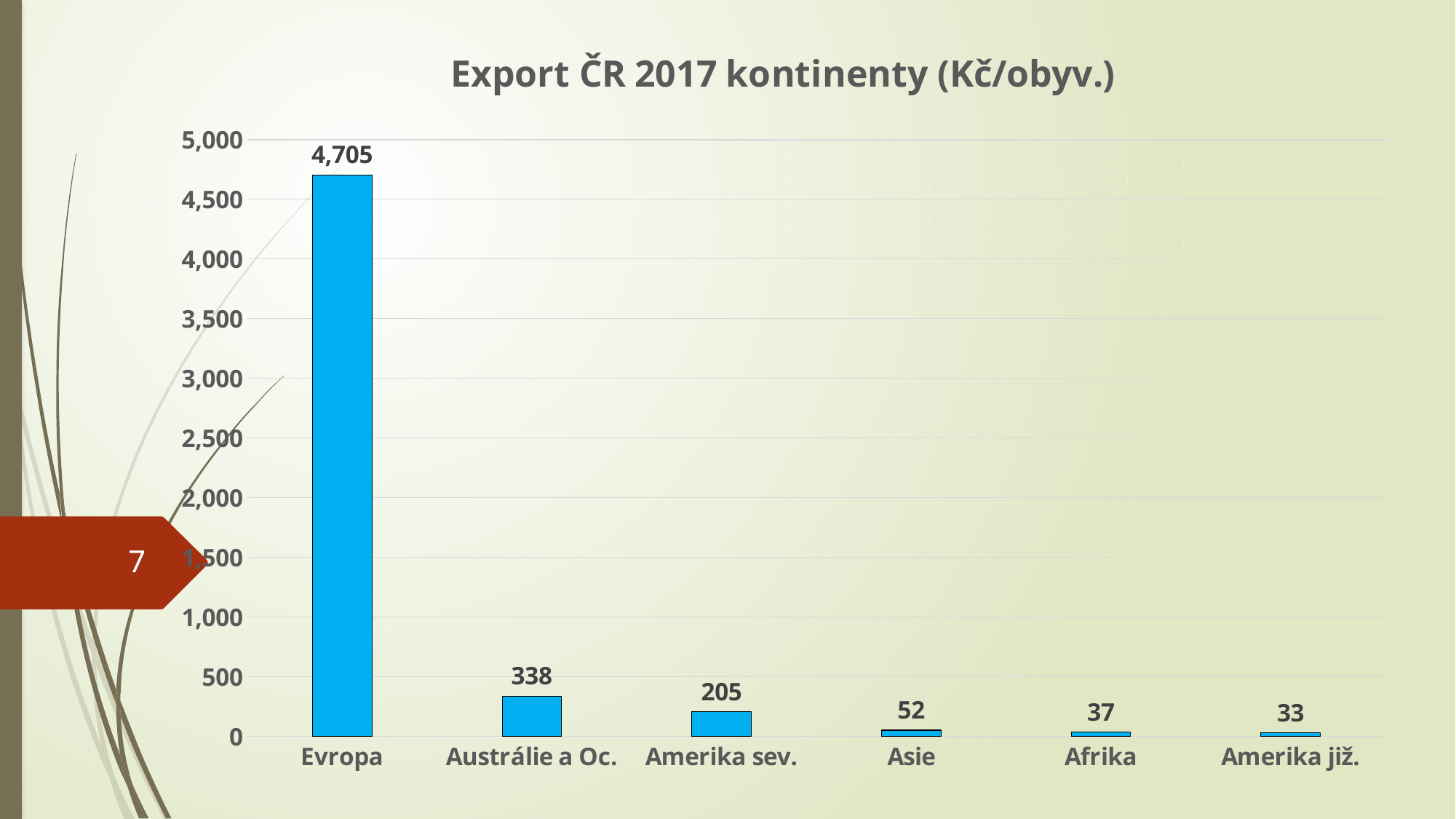
Is the value for Evropa greater or less than 4,500? greater What is the value for Evropa? 4,705 Which is larger, the value for Amerika sev. or the value for Asie? Amerika sev. What is the difference between the values for Evropa and Austrálie a Oc.? 4,367 How many categories are shown on the x axis? 6 Which category has the lowest value? Amerika již. What is the value for Asie? 52 Which category has the highest value? Evropa What is the value for Austrálie a Oc.? 338 What is the difference between the values for Afrika and Amerika již.? 4 What is the value for Amerika sev.? 205 What kind of chart is shown on the slide? bar chart